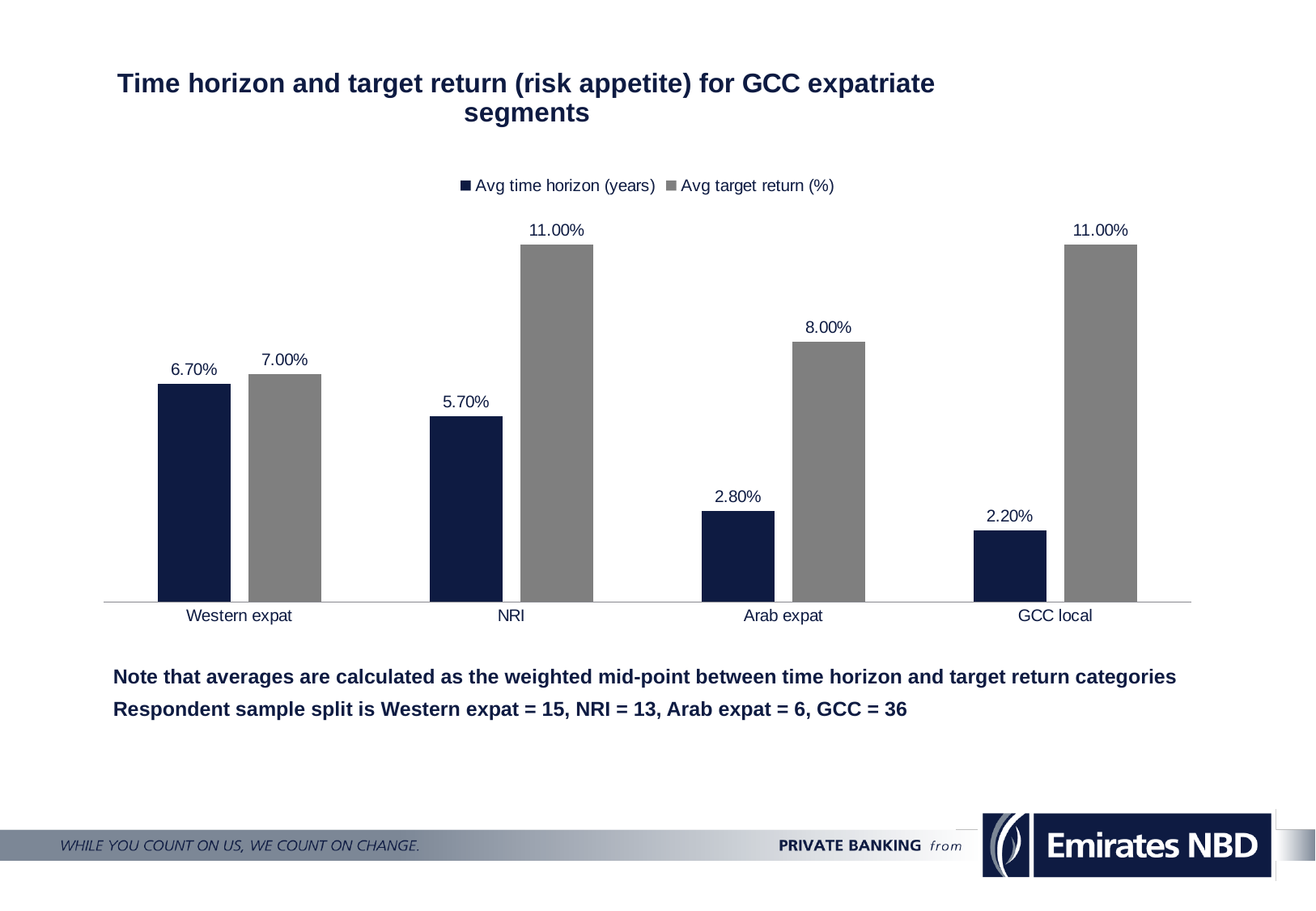
Which category has the lowest Avg target return (%) value? Western expat What is the difference between the Avg target return (%) values for NRI and Arab expat? 3.00% What is the Avg target return (%) value for NRI? 11.00% Which is larger: the Avg time horizon (years) value for NRI or for Arab expat? NRI Which category has the highest Avg time horizon (years) value? Western expat Which category has the lowest Avg time horizon (years) value? GCC local What is the Avg time horizon (years) value for GCC local? 2.20% What kind of chart is shown on the slide? Bar chart How many categories are shown on the x axis? 4 How many series does the legend list? 2 What is the Avg target return (%) value for Arab expat? 8.00% What is the Avg time horizon (years) value for Western expat? 6.70%